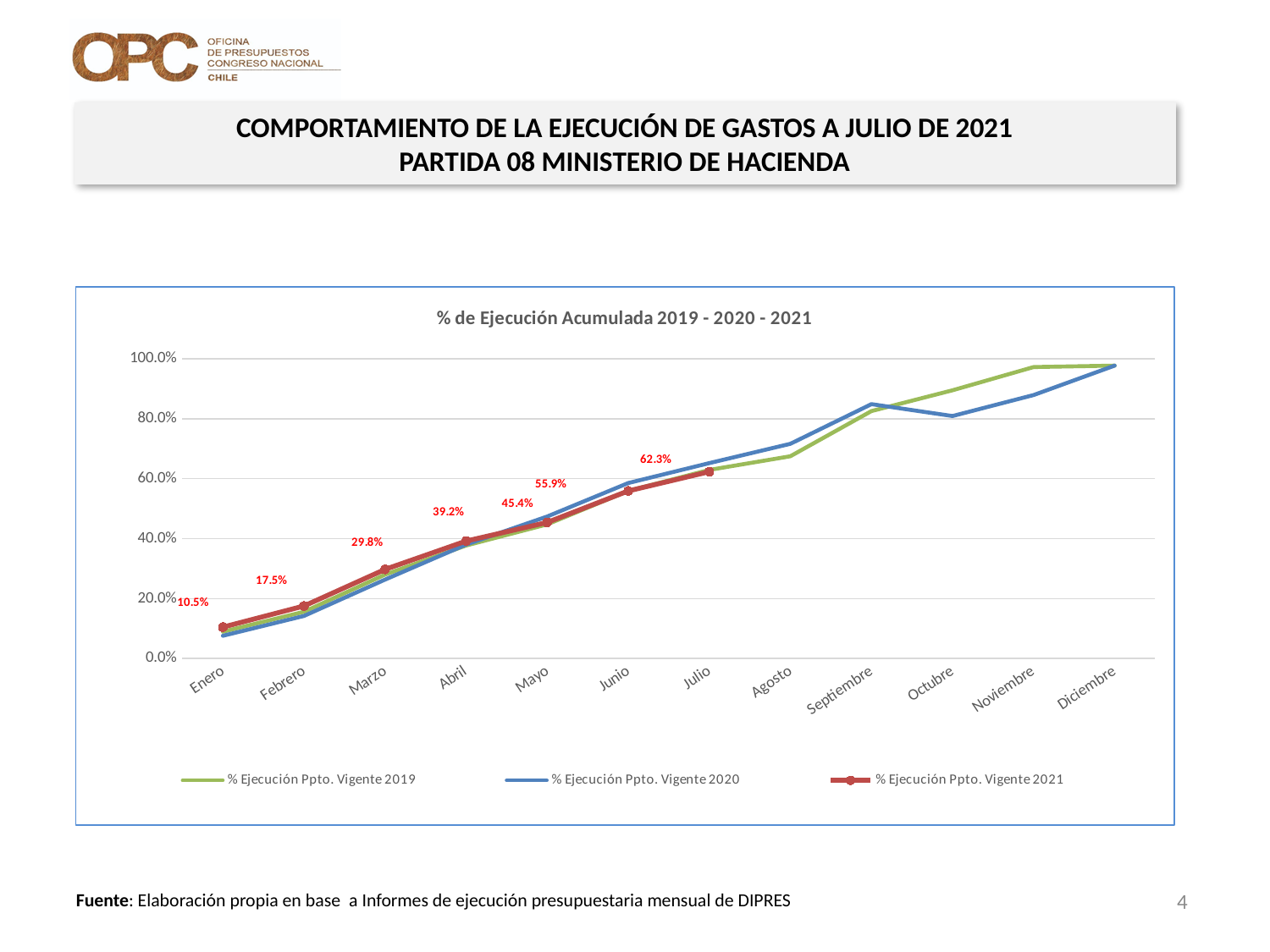
In which month does the % Ejecución Ppto. Vigente 2021 series have its lowest value? Enero How many series does the legend list? 3 In which month does the % Ejecución Ppto. Vigente 2021 series reach its highest value? Julio What is the title of the chart? % de Ejecución Acumulada 2019 - 2020 - 2021 What is the value for % Ejecución Ppto. Vigente 2021 in Julio? 62.3% Is the value for % Ejecución Ppto. Vigente 2019 in Noviembre greater or less than 80.0%? greater What is the value for % Ejecución Ppto. Vigente 2021 in Enero? 10.5% What kind of chart is shown on the slide? Line chart How many months are shown on the x axis? 12 What is the difference between the 2021 values for Julio and Enero? 51.8 percentage points What is the difference between the 2021 values for Junio and Mayo? 10.5 percentage points What is the value for % Ejecución Ppto. Vigente 2021 in Marzo? 29.8%